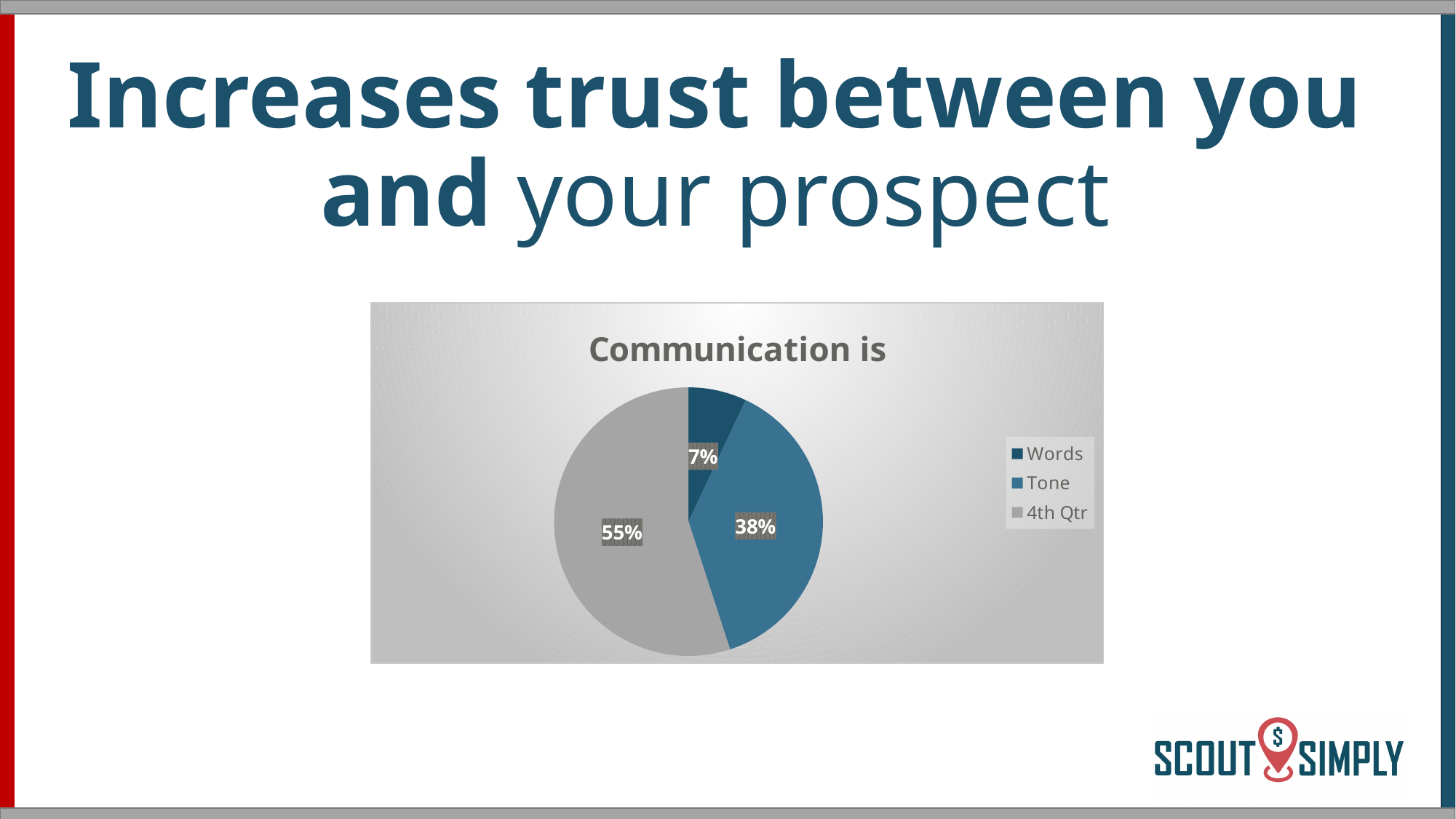
Which is larger, the Tone slice or the 4th Qtr slice? 4th Qtr Which category has the largest slice of the pie? 4th Qtr What is the difference in percentage points between the 4th Qtr slice and the Tone slice? 17 What percentage does the Tone slice represent? 38% What percentage does the 4th Qtr slice represent? 55% Which category has the smallest slice of the pie? Words What kind of chart is shown on the slide? pie chart How many entries does the legend list? 3 What percentage does the Words slice represent? 7% What is the difference in percentage points between the Tone slice and the Words slice? 31 How many slices does the pie chart have? 3 What is the title of the chart? Communication is